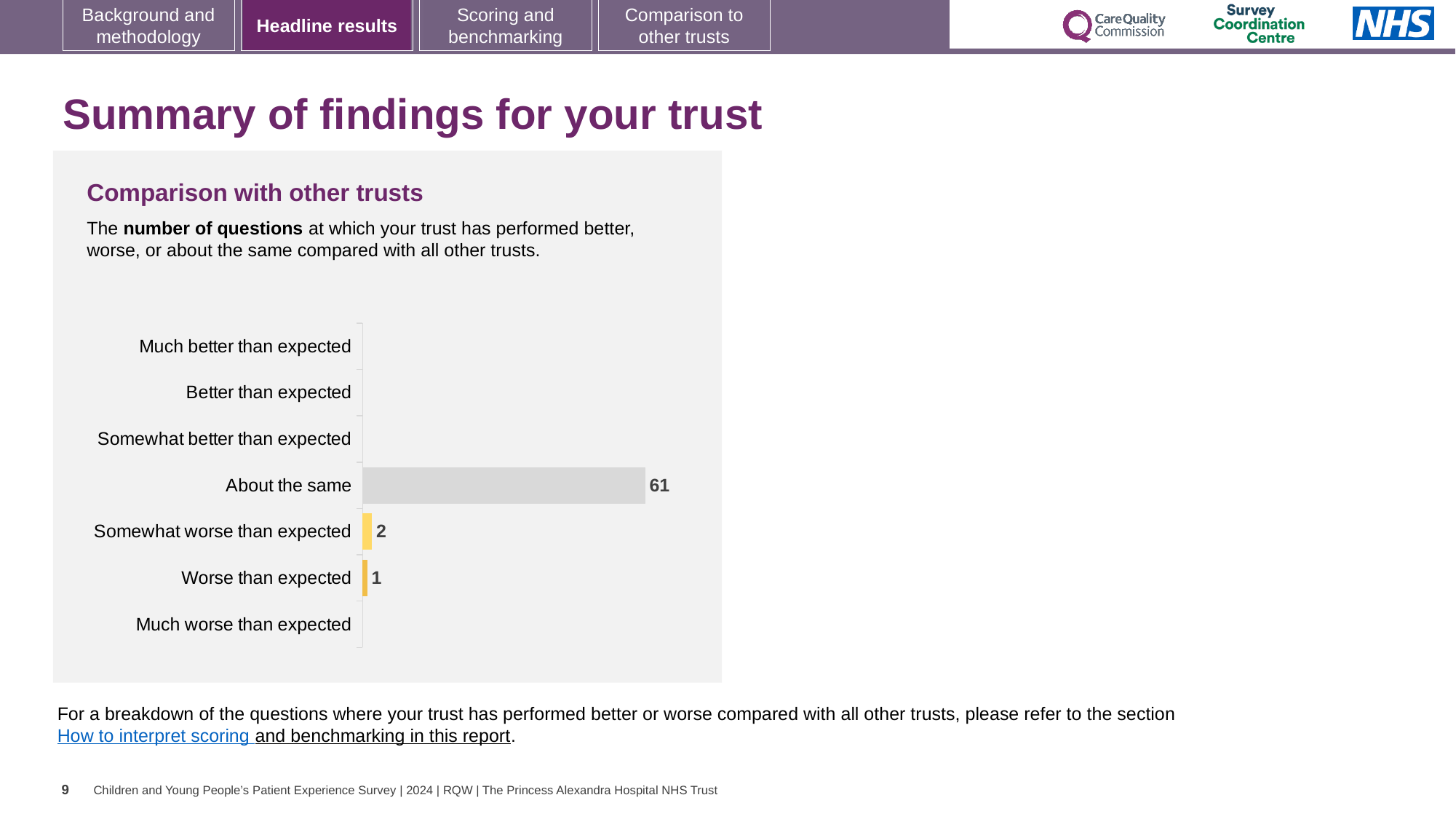
What is the total of the three labelled values in the Comparison with other trusts chart? 64 What kind of chart is shown on the slide? Bar chart What is the value for 'Worse than expected' in the Comparison with other trusts chart? 1 What is the difference between the values for 'About the same' and 'Somewhat worse than expected'? 59 What colour is the bar for 'About the same'? Grey What is the value for 'Somewhat worse than expected' in the Comparison with other trusts chart? 2 How many categories are listed on the axis of the Comparison with other trusts chart? 7 What is the title of the chart on the slide? Comparison with other trusts What is the value for 'About the same' in the Comparison with other trusts chart? 61 What is the difference between the values for 'Somewhat worse than expected' and 'Worse than expected'? 1 Which is larger: the value for 'Somewhat worse than expected' or the value for 'Worse than expected'? Somewhat worse than expected Which category has the highest value in the Comparison with other trusts chart? About the same